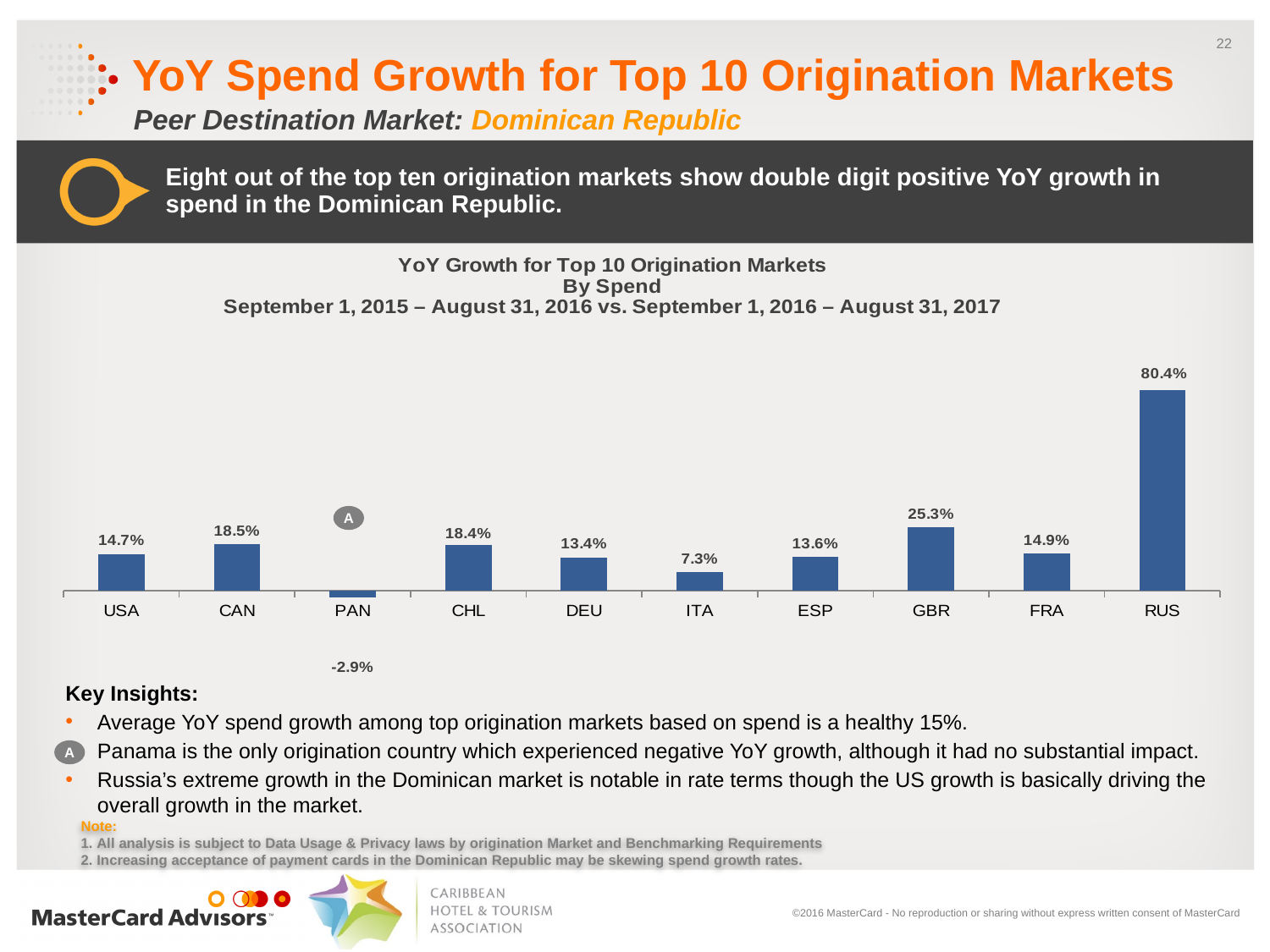
Which has a higher YoY spend growth, FRA or ITA? FRA What kind of chart is used to show YoY growth for the top 10 origination markets? Bar chart Which has a higher YoY spend growth, DEU or ESP? ESP What is the difference between the YoY spend growth for RUS and GBR? 55.1% What is the YoY spend growth value for GBR? 25.3% What is the difference between the YoY spend growth for CAN and ITA? 11.2% Which origination market has the lowest YoY spend growth? PAN What is the YoY spend growth value for CHL? 18.4% What is the YoY spend growth value for USA? 14.7% How many origination markets are shown in the chart? 10 What is the YoY spend growth value for PAN? -2.9% Which origination market has the highest YoY spend growth? RUS